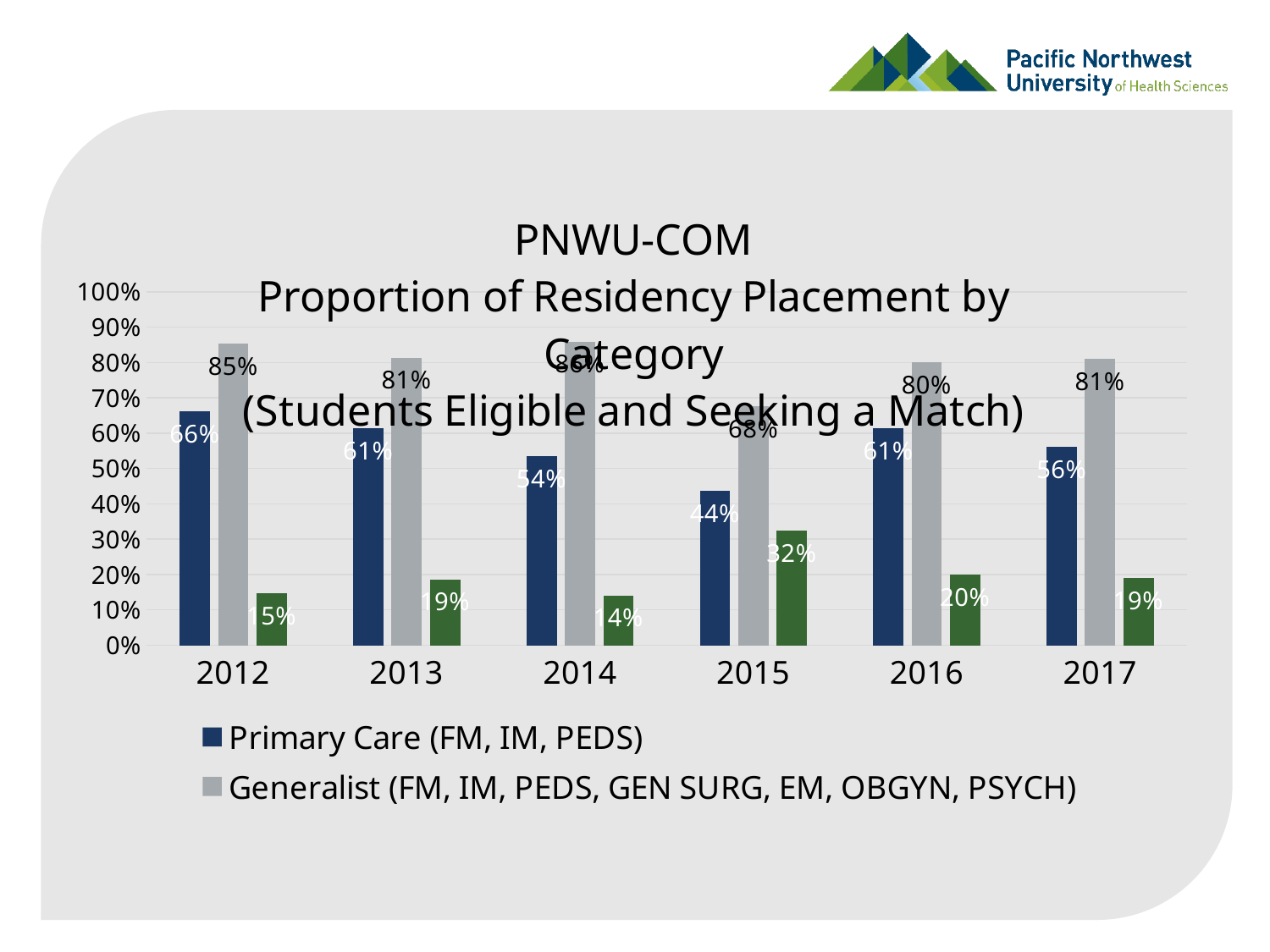
What is the difference between the Generalist and Primary Care values in 2012? 19 percentage points What is the Generalist value for 2015? 68% In which year is the Generalist value lowest? 2015 Is the Primary Care (FM, IM, PEDS) value for 2015 greater or less than 50%? less What is the Generalist value for 2016? 80% In which year is the Primary Care (FM, IM, PEDS) value lowest? 2015 How many series does the legend list? 2 How many years are shown on the x axis? 6 What kind of chart is shown on the slide? bar chart What is the Primary Care (FM, IM, PEDS) value for 2012? 66% What is the Primary Care (FM, IM, PEDS) value for 2017? 56% Which year has the higher Primary Care (FM, IM, PEDS) value, 2012 or 2017? 2012